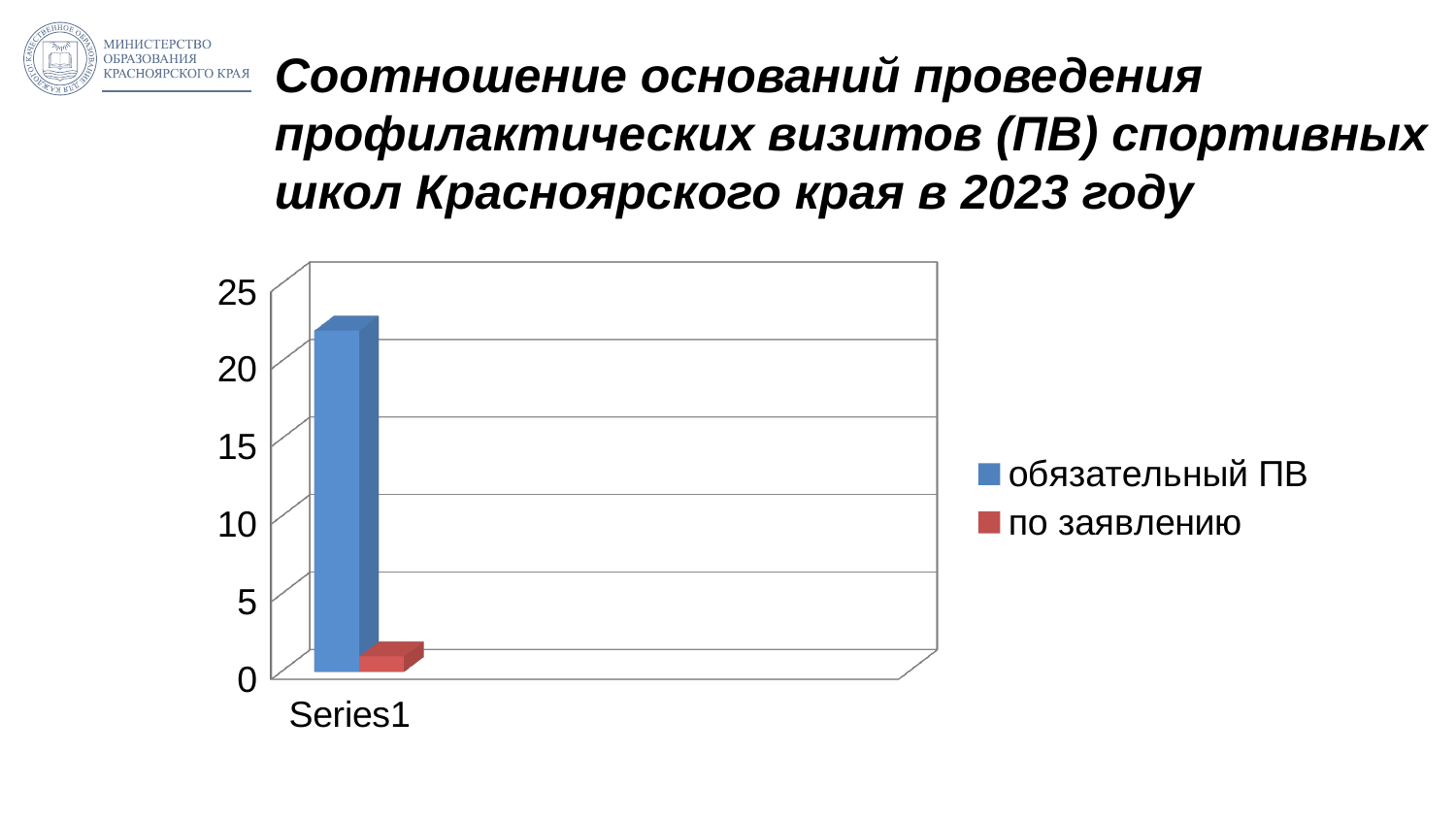
What is the label of the category on the x axis? Series1 How many series does the legend list? 2 Is the value for по заявлению greater or less than 5? less Is the value for обязательный ПВ greater or less than 20? greater What kind of chart is shown on the slide? bar chart How many categories are shown on the x axis? 1 Which series has the highest value? обязательный ПВ Is the value for обязательный ПВ greater or less than 25? less Which series has the lowest value? по заявлению What colour is the bar for по заявлению? red Which is larger, the value for обязательный ПВ or the value for по заявлению? обязательный ПВ